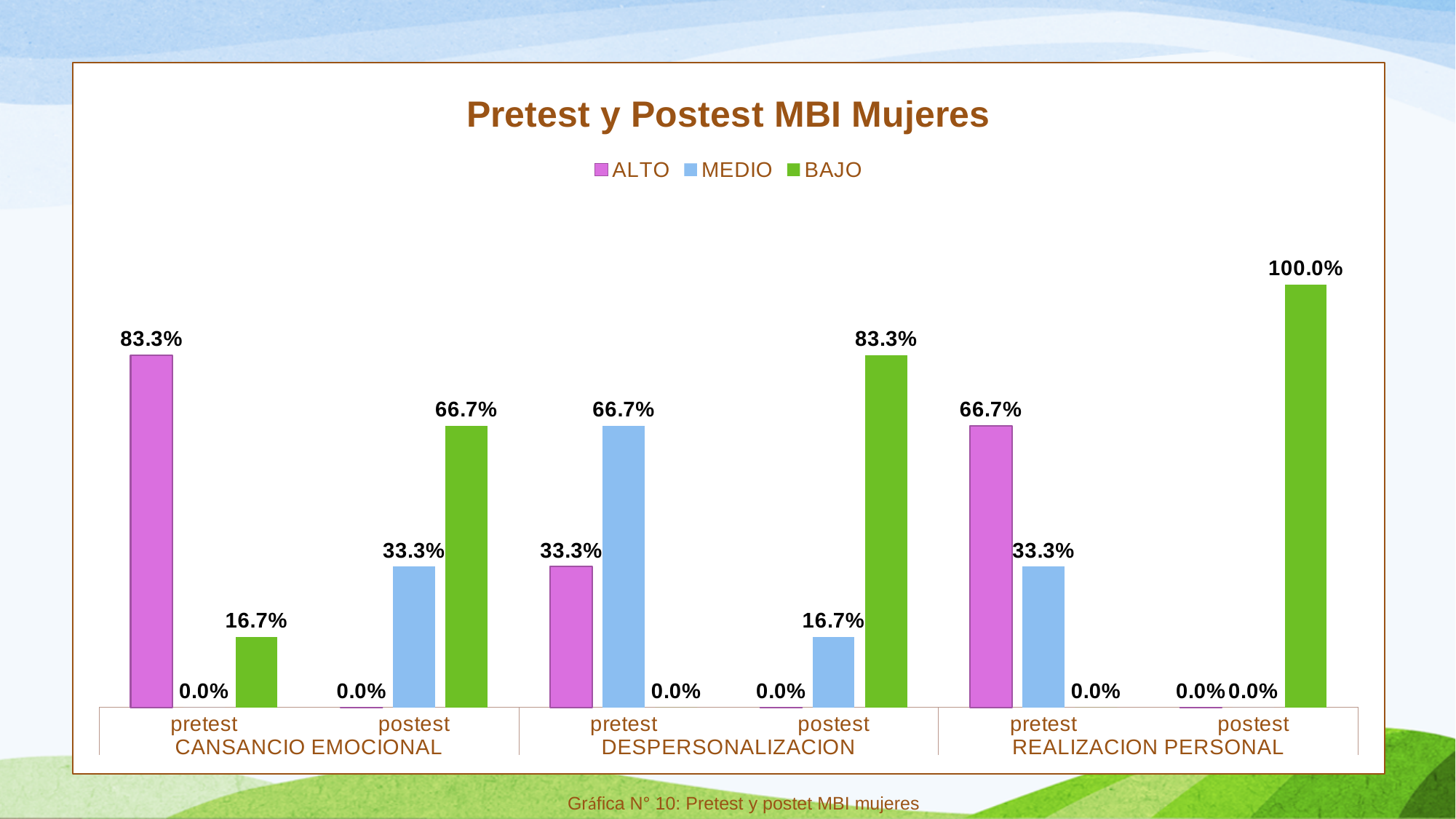
What is the BAJO value for the REALIZACION PERSONAL postest? 100.0% What is the MEDIO value for the DESPERSONALIZACION pretest? 66.7% What is the title of the chart? Pretest y Postest MBI Mujeres What is the ALTO value for the CANSANCIO EMOCIONAL pretest? 83.3% Which category has the highest ALTO value? CANSANCIO EMOCIONAL pretest How many series does the legend list? 3 How many pretest/postest category groups are shown on the x axis? 6 What is the MEDIO value for the DESPERSONALIZACION postest? 16.7% What is the difference between the BAJO value for the CANSANCIO EMOCIONAL postest and the BAJO value for the CANSANCIO EMOCIONAL pretest? 50.0% Which category has the highest BAJO value? REALIZACION PERSONAL postest Which is larger: the ALTO value for the REALIZACION PERSONAL pretest or the ALTO value for the DESPERSONALIZACION pretest? REALIZACION PERSONAL pretest What kind of chart is shown on the slide? Bar chart